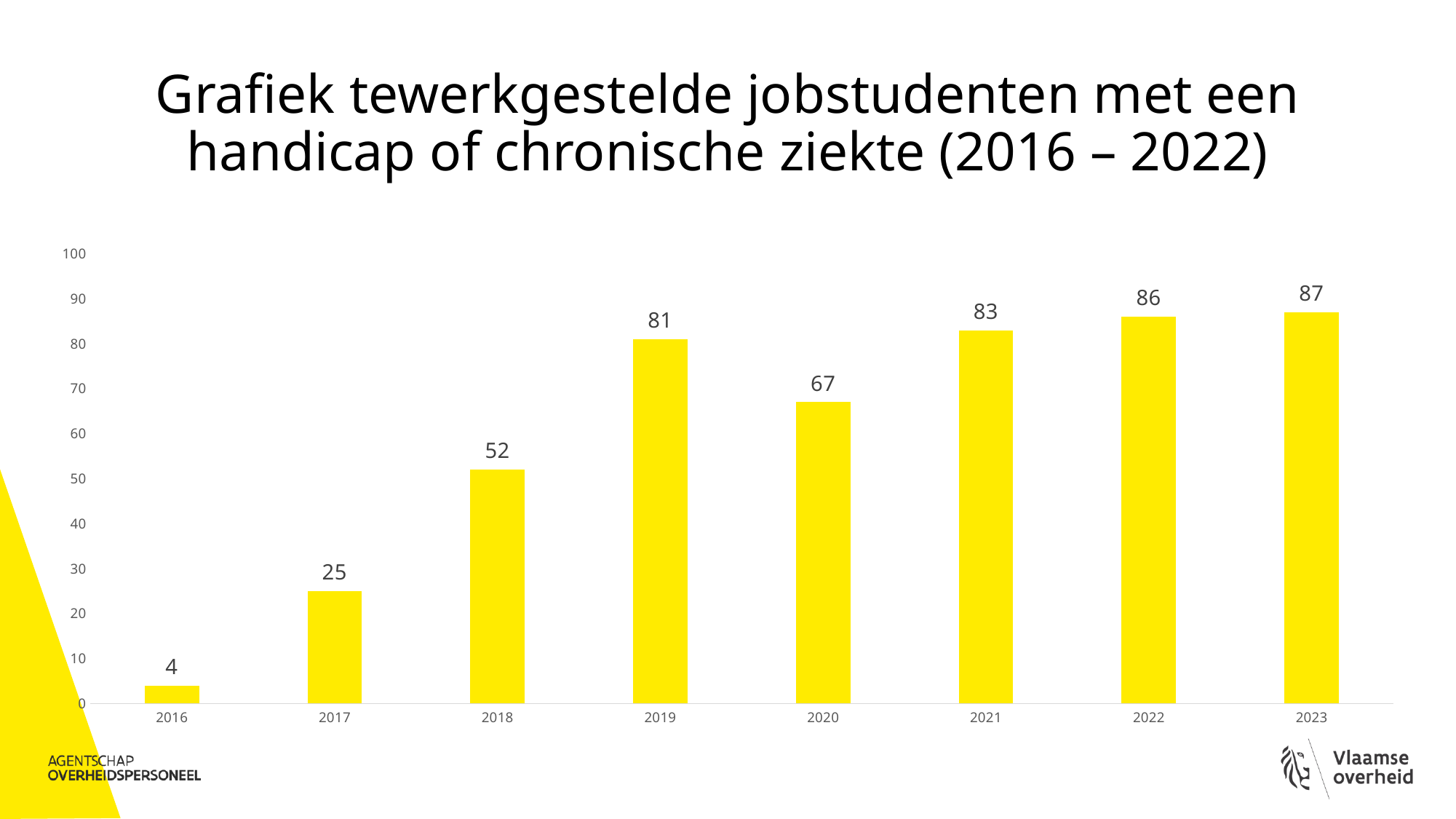
What kind of chart is shown on the slide? bar chart Is the value for 2021 greater or less than 80? greater What is the value for 2016? 4 What is the value for 2020? 67 Which year has the lowest value? 2016 Do the values rise or fall from 2016 to 2019? rise What is the difference between the values for 2018 and 2017? 27 What is the value for 2019? 81 Which is larger, the value for 2019 or the value for 2020? 2019 Which year has the highest value? 2023 How many years are shown on the x axis? 8 What is the difference between the values for 2023 and 2016? 83